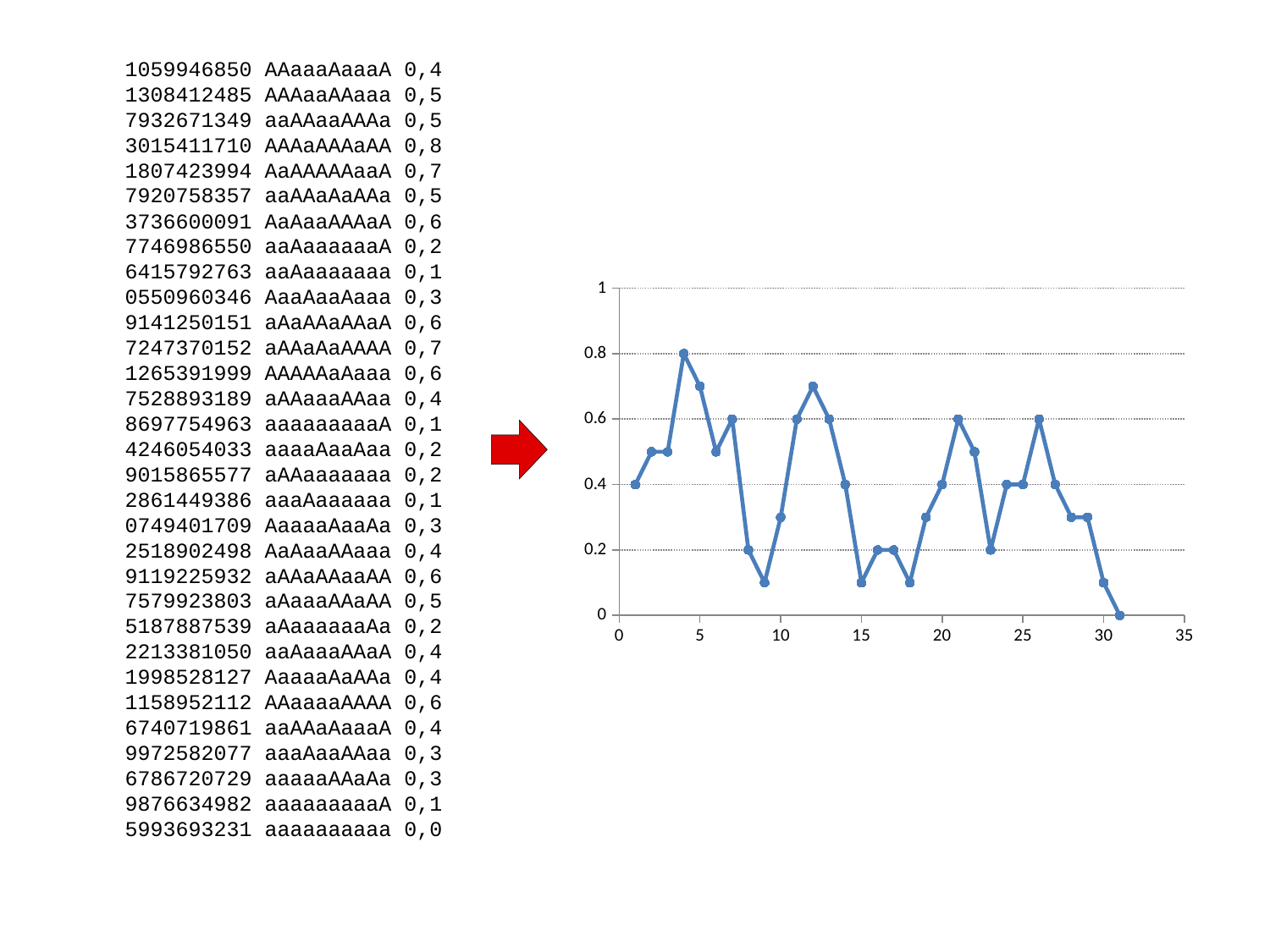
What is the highest value plotted on the line chart? 0.8 At which x value does the line chart reach its highest point? 4 What is the value plotted at x = 1 on the line chart? 0.4 At which x value does the line chart reach its lowest point? 31 What is the value plotted at x = 21 on the line chart? 0.6 What is the difference between the value at x = 4 and the value at x = 1? 0.4 Is the value at x = 9 greater or less than 0.2? less What is the value plotted at x = 31 on the line chart? 0 Which is larger, the value at x = 4 or the value at x = 12? x = 4 How many data points are plotted on the line chart? 31 What kind of chart is shown on the slide? line chart Is the value at x = 5 greater or less than 0.6? greater